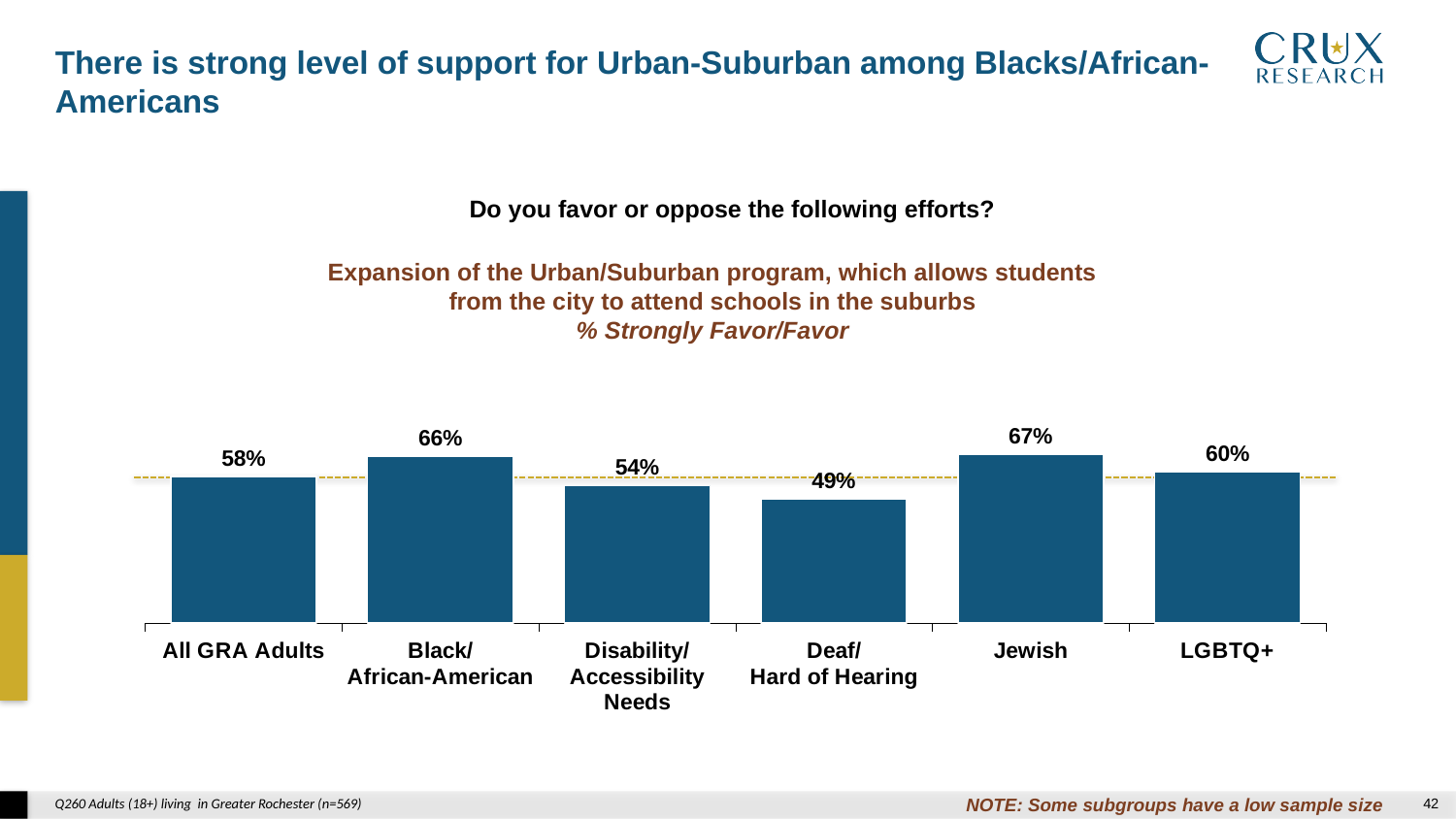
Which is larger, the value for LGBTQ+ or the value for Disability/Accessibility Needs? LGBTQ+ Which group has the highest level of support for the Urban/Suburban program expansion? Jewish What is the difference between the Jewish group's value and the All GRA Adults value? 9 percentage points What percentage of All GRA Adults strongly favor/favor expansion of the Urban/Suburban program? 58% What is the value shown for the Black/African-American group? 66% How many groups are shown on the chart? 6 What is the difference between the Black/African-American value and the Disability/Accessibility Needs value? 12 percentage points What is the value shown for the Deaf/Hard of Hearing group? 49% Which group has the lowest level of support for the Urban/Suburban program expansion? Deaf/Hard of Hearing What is the value shown for the LGBTQ+ group? 60% What kind of chart is shown on the slide? Bar chart